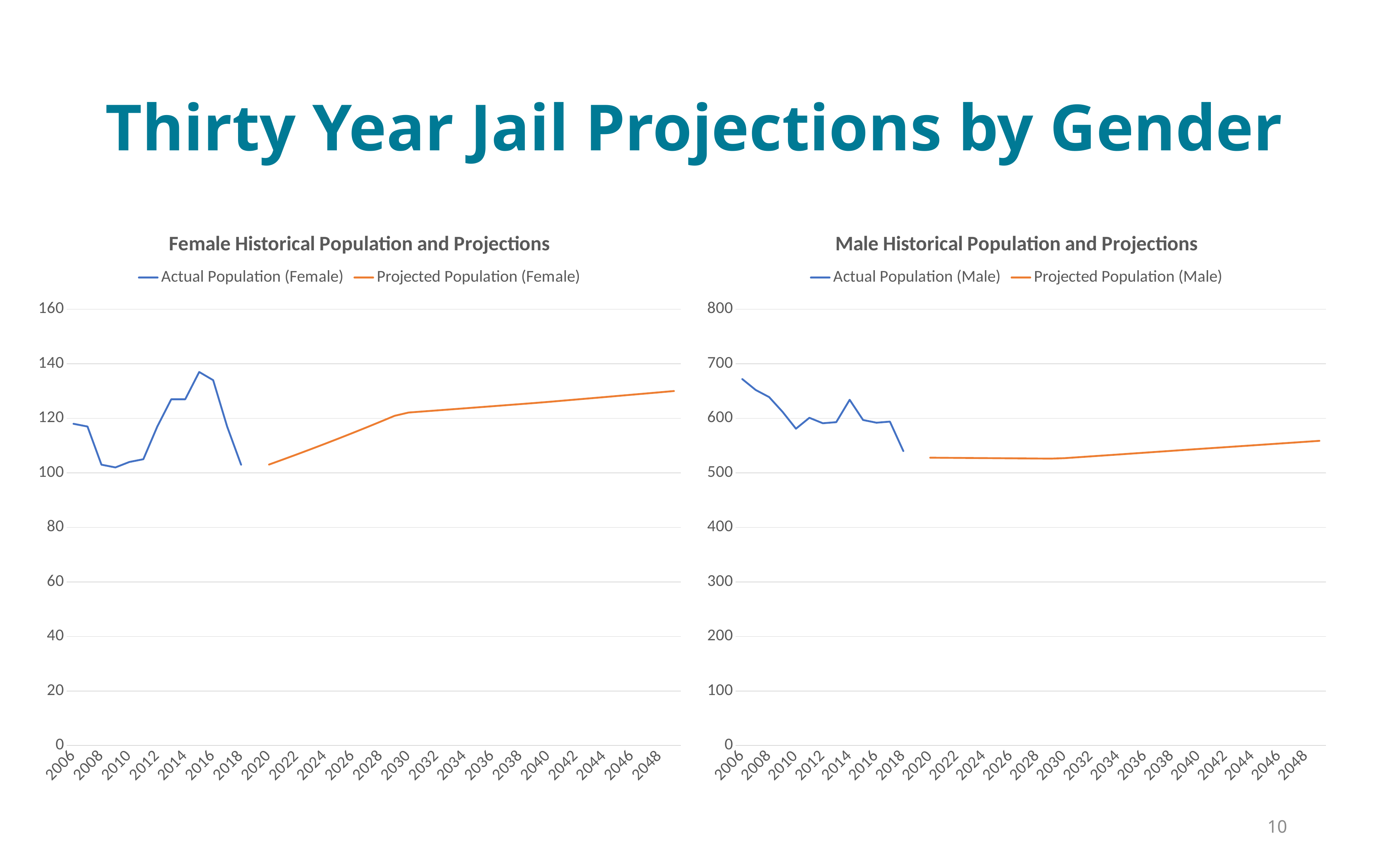
In the Male Historical Population and Projections chart, does the Actual Population (Male) line rise or fall overall from 2006 to 2018? fall In the Male Historical Population and Projections chart, is the Actual Population (Male) value for 2018 greater or less than 600? less What is the title of the chart on the right side of the slide? Male Historical Population and Projections How many series does the legend of the Male Historical Population and Projections chart list? 2 In the Female Historical Population and Projections chart, what colour is the Projected Population (Female) line? orange In the Female Historical Population and Projections chart, is the Projected Population (Female) value for 2048 greater or less than 120? greater In the Female Historical Population and Projections chart, is the Actual Population (Female) value for 2006 greater or less than 100? greater What kind of chart is the Female Historical Population and Projections chart? line chart In the Male Historical Population and Projections chart, which year has the highest Actual Population (Male) value? 2006 In the Female Historical Population and Projections chart, does the Projected Population (Female) line rise or fall from 2020 to 2048? rise